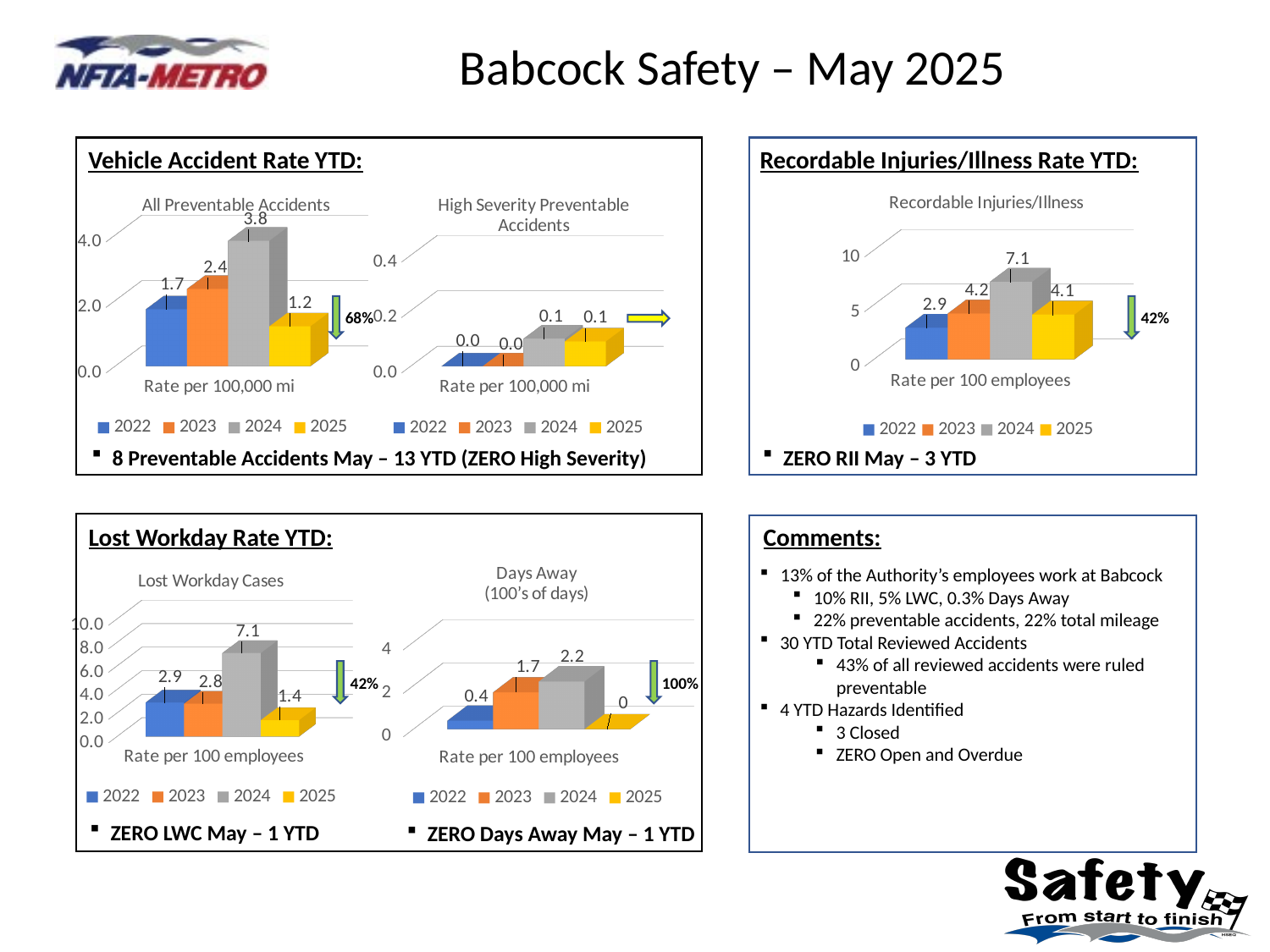
In the 'Recordable Injuries/Illness' chart, which year has the highest value? 2024 In the 'All Preventable Accidents' chart, what is the difference between the 2024 and 2025 values? 2.6 In the 'Recordable Injuries/Illness' chart, what is the value for 2023? 4.2 In the 'Days Away' chart, what is the total of the 2022 and 2024 values? 2.6 In the 'High Severity Preventable Accidents' chart, what is the value for 2025? 0.1 In the 'Days Away' chart, what is the value for 2023? 1.7 How many series does the legend of the 'Lost Workday Cases' chart list? 4 In the 'Recordable Injuries/Illness' chart, is the value for 2024 greater or less than 5? greater In the 'All Preventable Accidents' chart, what is the value for 2024? 3.8 In the 'Lost Workday Cases' chart, which is larger, the value for 2022 or the value for 2025? 2022 In the 'Lost Workday Cases' chart, what is the value for 2025? 1.4 In the 'All Preventable Accidents' chart, which year has the lowest value? 2025